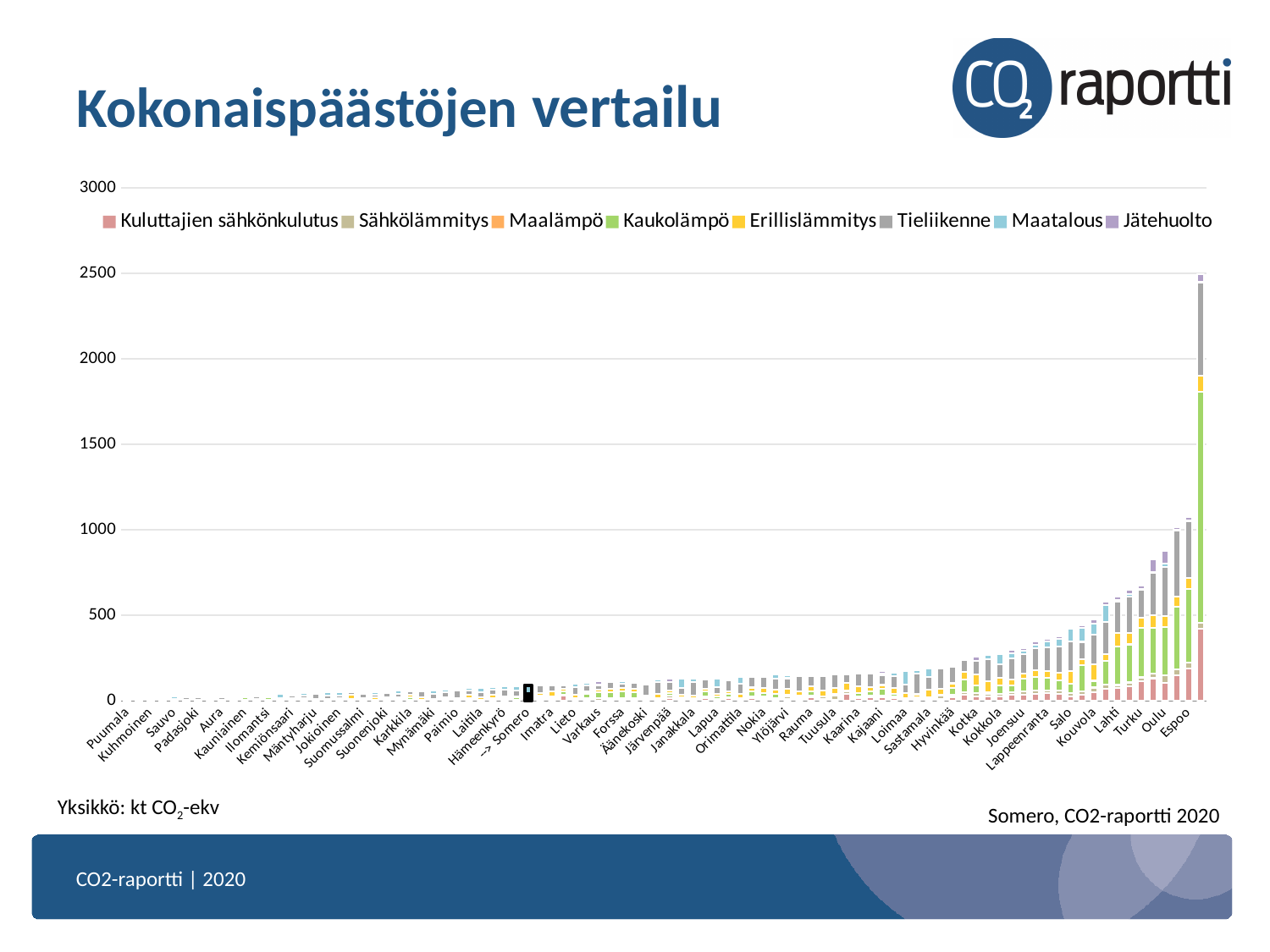
Is the total value for Lahti greater or less than 500? greater What is the title of the chart? Kokonaispäästöjen vertailu Which has the larger total, Espoo or Turku? Espoo Is the total value for Oulu greater or less than 1000? less Is the total value for Espoo greater or less than 2000? less Which has the larger total, Puumala or Kouvola? Kouvola What kind of chart is shown on the slide? Stacked bar chart Do the bar totals generally rise or fall from left to right along the x axis? Rise How many series does the legend list? 8 What unit is stated for the chart values? kt CO2-ekv